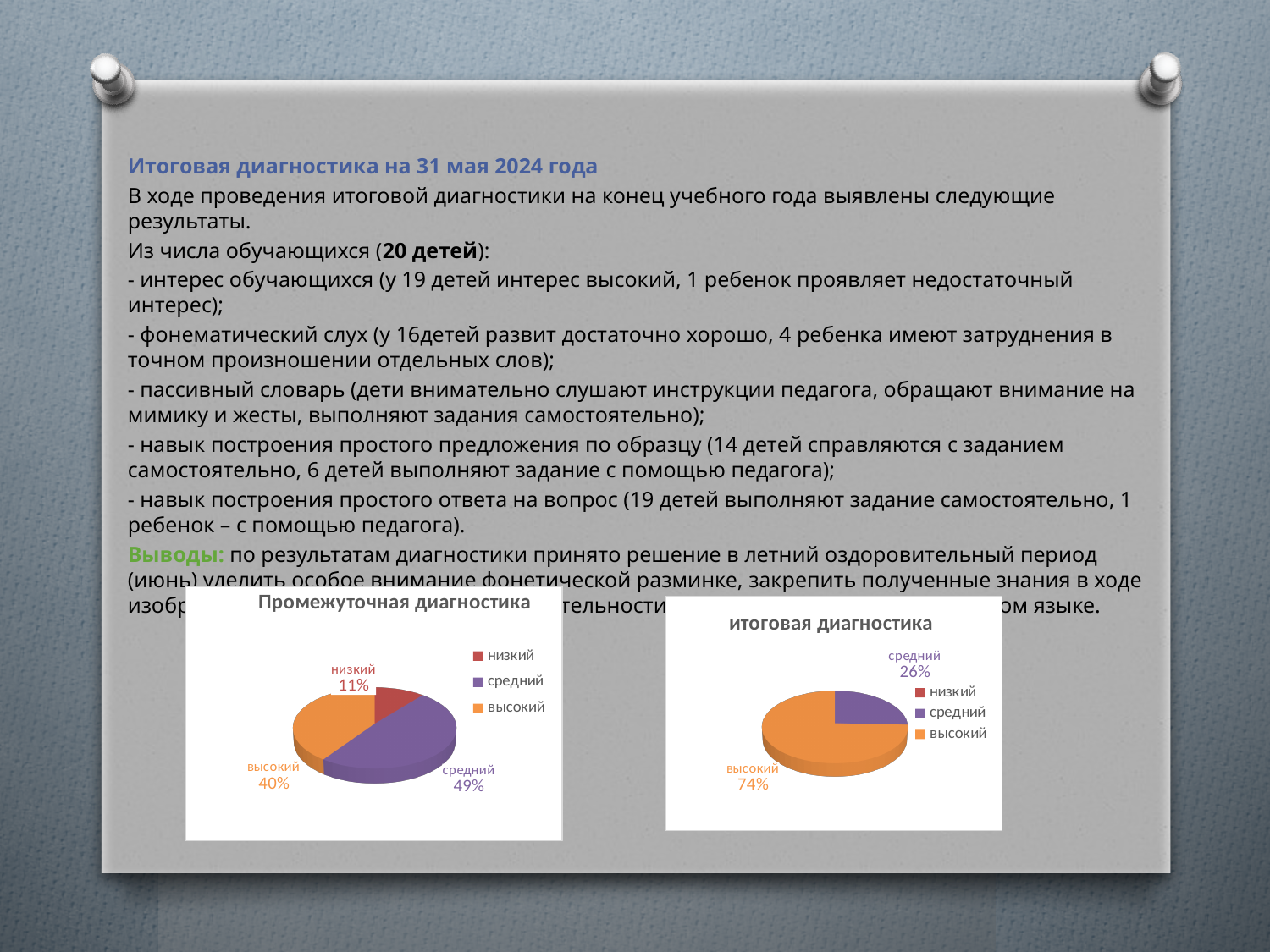
In the chart titled "Промежуточная диагностика", what share does the "средний" slice have? 49% In the chart titled "итоговая диагностика", which category has the largest slice? высокий In the chart titled "Промежуточная диагностика", which category has the smallest slice? низкий In the chart titled "Промежуточная диагностика", what is the difference in percentage points between the "средний" and "высокий" slices? 9 What type of chart is the chart titled "итоговая диагностика"? pie chart In the chart titled "итоговая диагностика", what share does the "средний" slice have? 26% In the chart titled "Промежуточная диагностика", what share does the "высокий" slice have? 40% In the chart titled "итоговая диагностика", is the "высокий" slice larger or smaller than the "средний" slice? larger In the chart titled "Промежуточная диагностика", what share does the "низкий" slice have? 11% How many entries does the legend of the chart titled "Промежуточная диагностика" list? 3 In the chart titled "Промежуточная диагностика", which category has the largest slice? средний In the chart titled "итоговая диагностика", what share does the "высокий" slice have? 74%